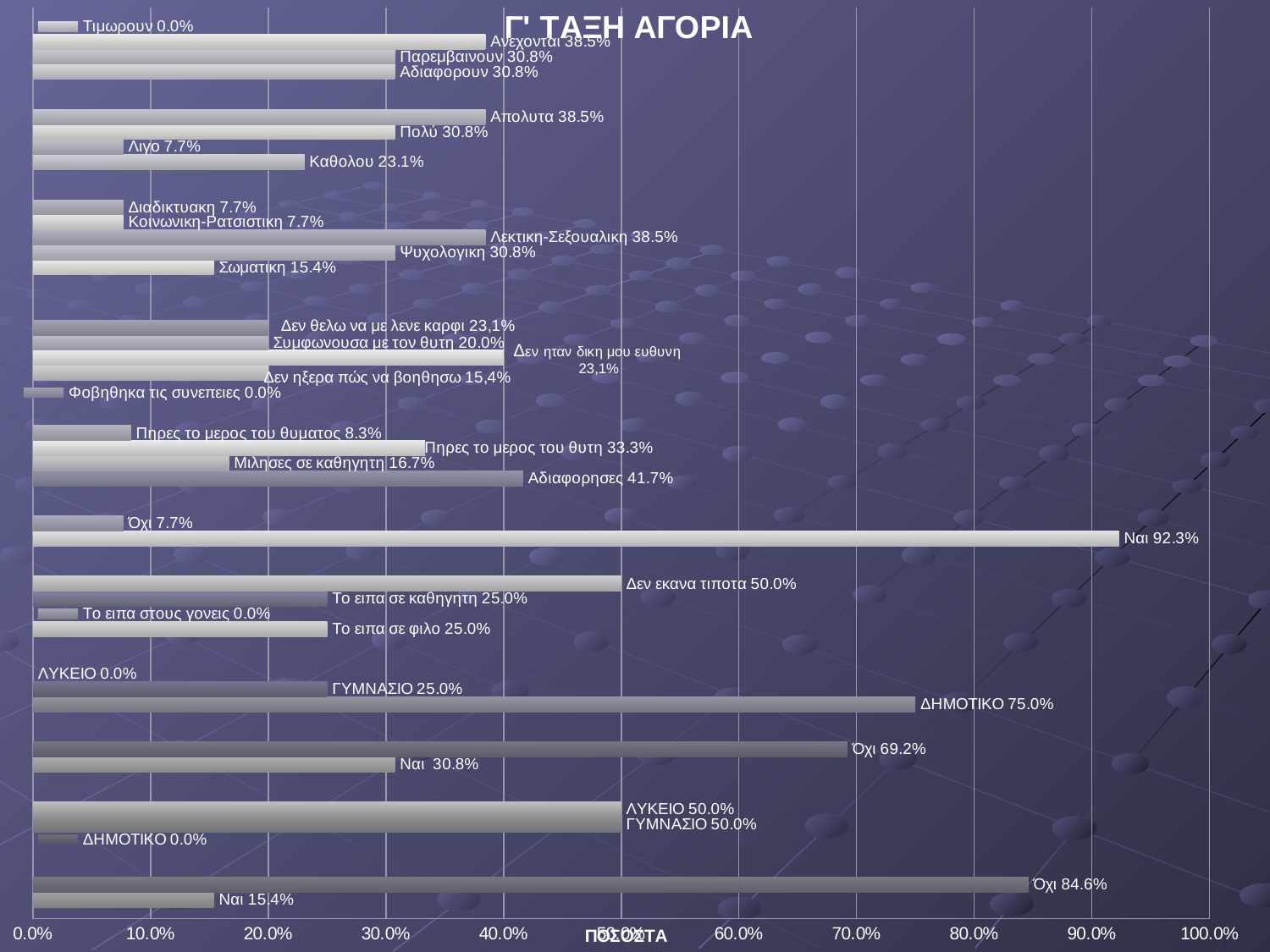
What is the value for Αδιαφορησες? 41.7% Which bar has the highest value on the whole chart? Ναι 92.3% What is the value for Λεκτικη-Σεξουαλικη? 38.5% What is the value for Καθολου? 23.1% Is the value for Ανεχονται greater or less than 30.0%? greater What is the value for ΔΗΜΟΤΙΚΟ 75.0% compared with ΓΥΜΝΑΣΙΟ 25.0% — what is the difference between them? 50.0% What is the value for Δεν εκανα τιποτα? 50.0% Which is larger, Πηρες το μερος του θυτη or Πηρες το μερος του θυματος? Πηρες το μερος του θυτη What type of chart is shown on the slide? bar chart What is the label of the horizontal axis? ΠΟΣΟΣΤΑ What is the difference between Ψυχολογικη and Σωματικη? 15.4% What is the title of the chart? Γ' ΤΑΞΗ ΑΓΟΡΙΑ